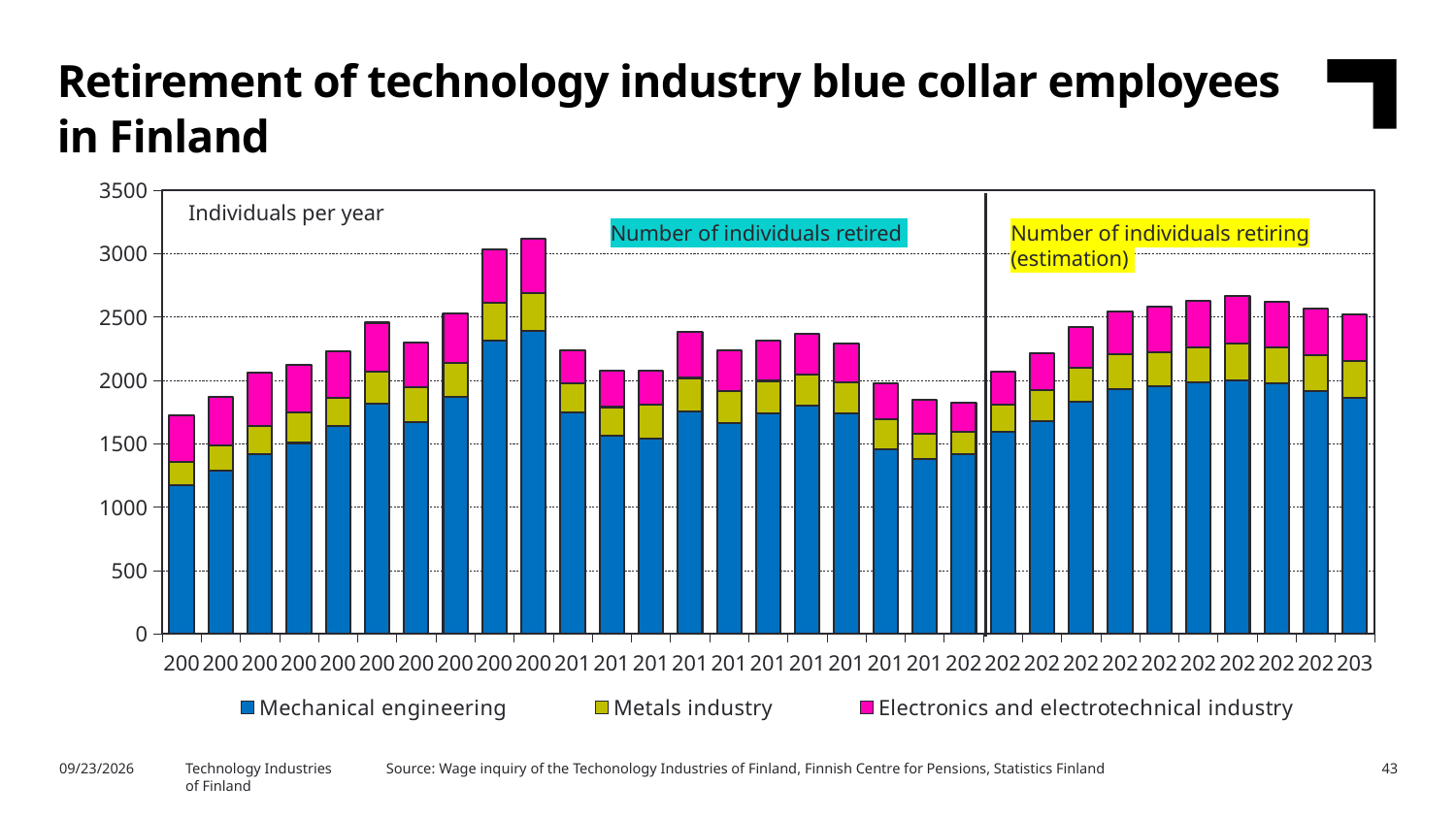
How many bars are plotted in the chart? 31 Is the total of the leftmost bar greater or less than 2000? less What does the yellow highlighted label on the right side of the chart say? Number of individuals retiring (estimation) Is the total of the tallest bar greater or less than 3000? greater Do the bar totals generally rise or fall across the first ten bars from left to right? rise What kind of chart is shown on the slide? Stacked bar chart What are the three series named in the legend? Mechanical engineering, Metals industry, Electronics and electrotechnical industry Is the total of the rightmost bar greater or less than 2000? greater Is the tallest bar located in the 'Number of individuals retired' section or the 'Number of individuals retiring (estimation)' section? Number of individuals retired How many series does the legend list? 3